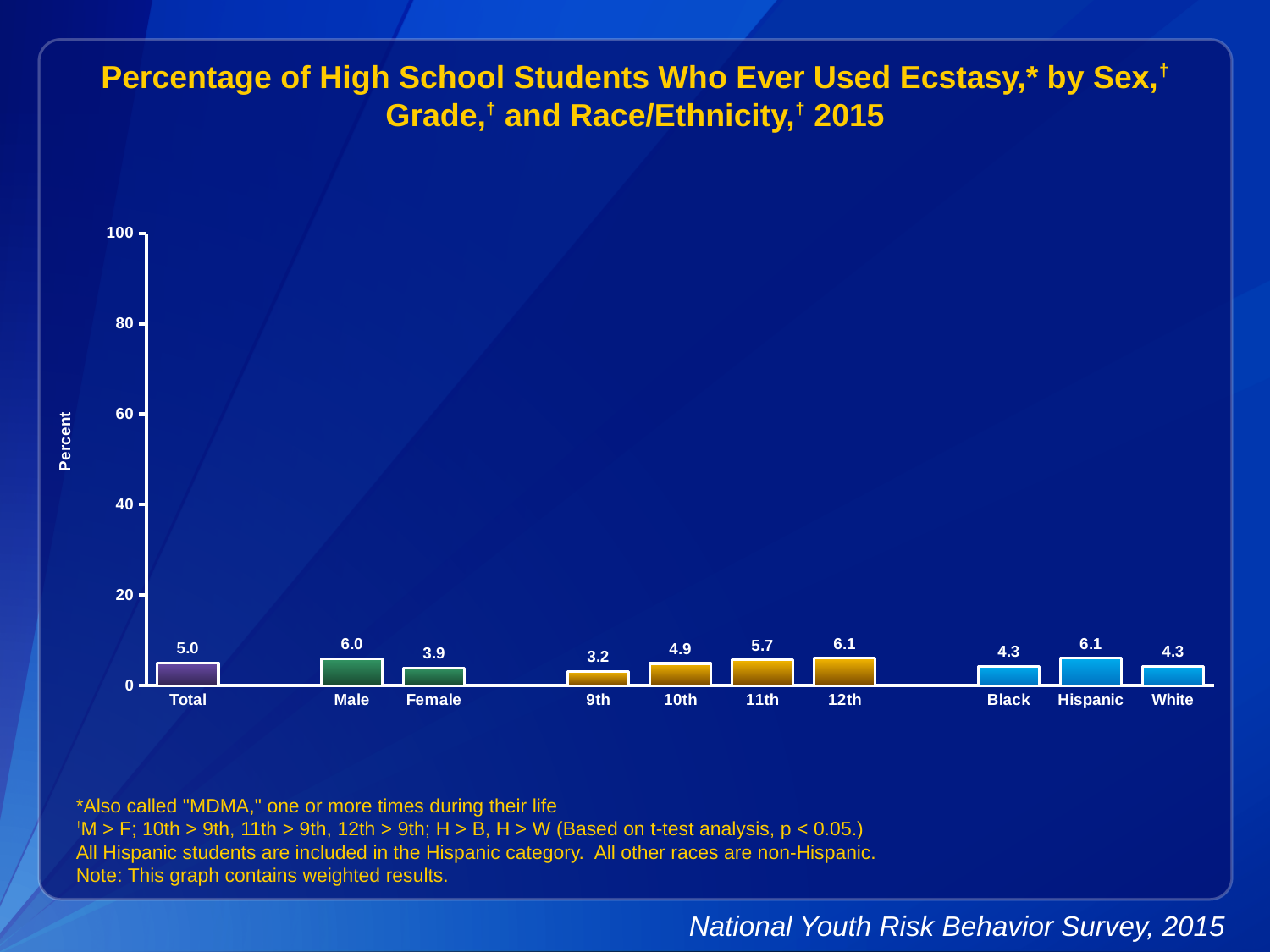
What is the value for Hispanic students? 6.1 Is the value for Male students greater or less than 20? less Which is larger, the value for Hispanic students or the value for Black students? Hispanic What is the percentage of high school students who ever used ecstasy for the Total category? 5.0 What kind of chart is shown on the slide? bar chart What is the value for Male students? 6.0 How many categories are shown on the x axis? 10 Which grade has the lowest percentage of students who ever used ecstasy? 9th What is the difference between the 12th grade and 9th grade values? 2.9 What is the value for 9th grade students? 3.2 What is the difference between the Male and Female values? 2.1 Which grade has the highest percentage of students who ever used ecstasy? 12th